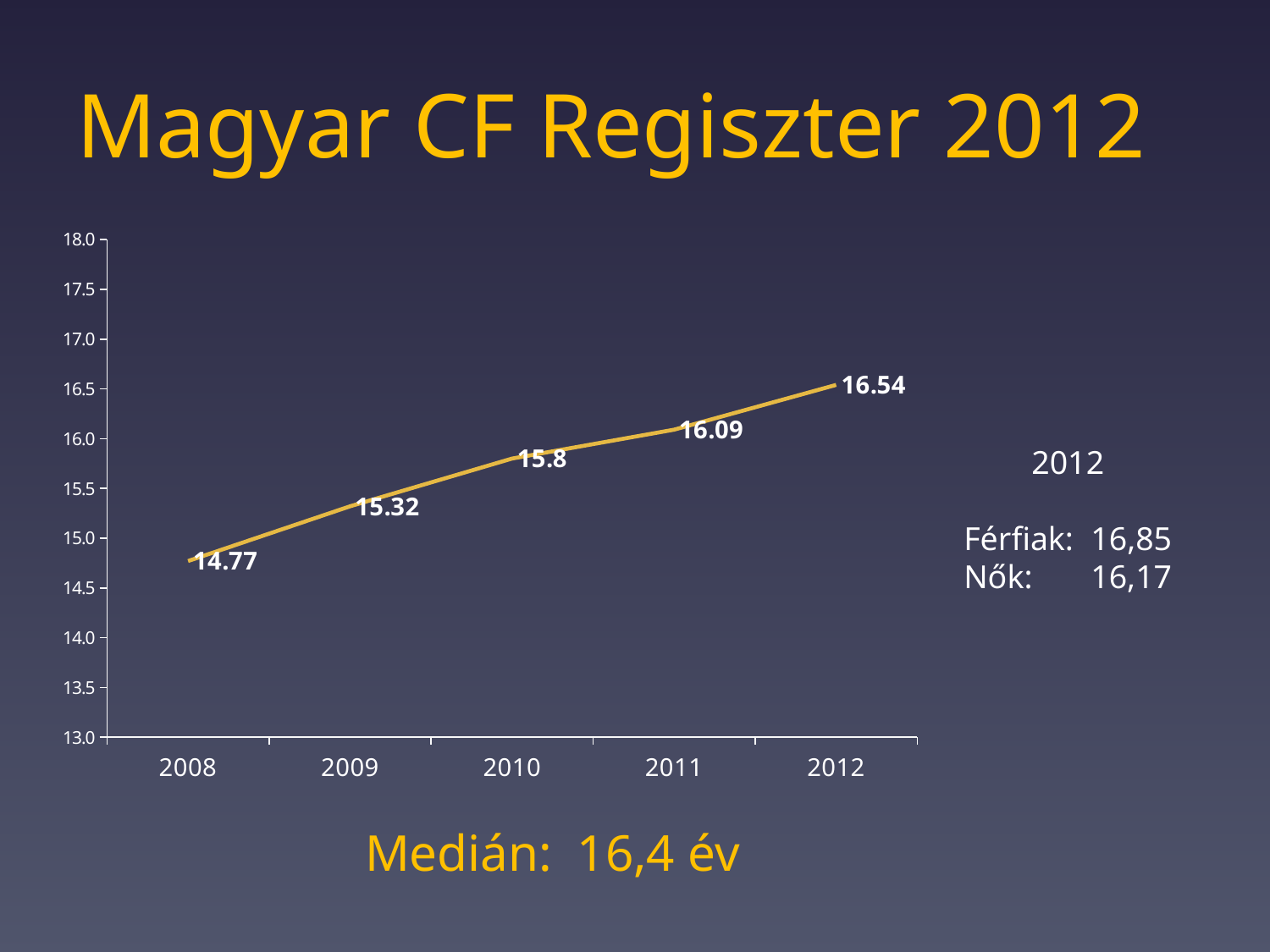
Which year has the lowest value on the chart? 2008 What is the value plotted for 2012? 16.54 Is the value for 2009 greater or less than 15.0? greater What is the value plotted for 2008? 14.77 What is the difference between the values for 2011 and 2010? 0.29 Do the values rise or fall from 2008 to 2012? rise What kind of chart is shown on the slide? line chart How many years are plotted on the chart? 5 Which is larger, the value for 2009 or the value for 2011? 2011 Which year has the highest value on the chart? 2012 What is the value plotted for 2010? 15.8 What is the difference between the values for 2012 and 2008? 1.77